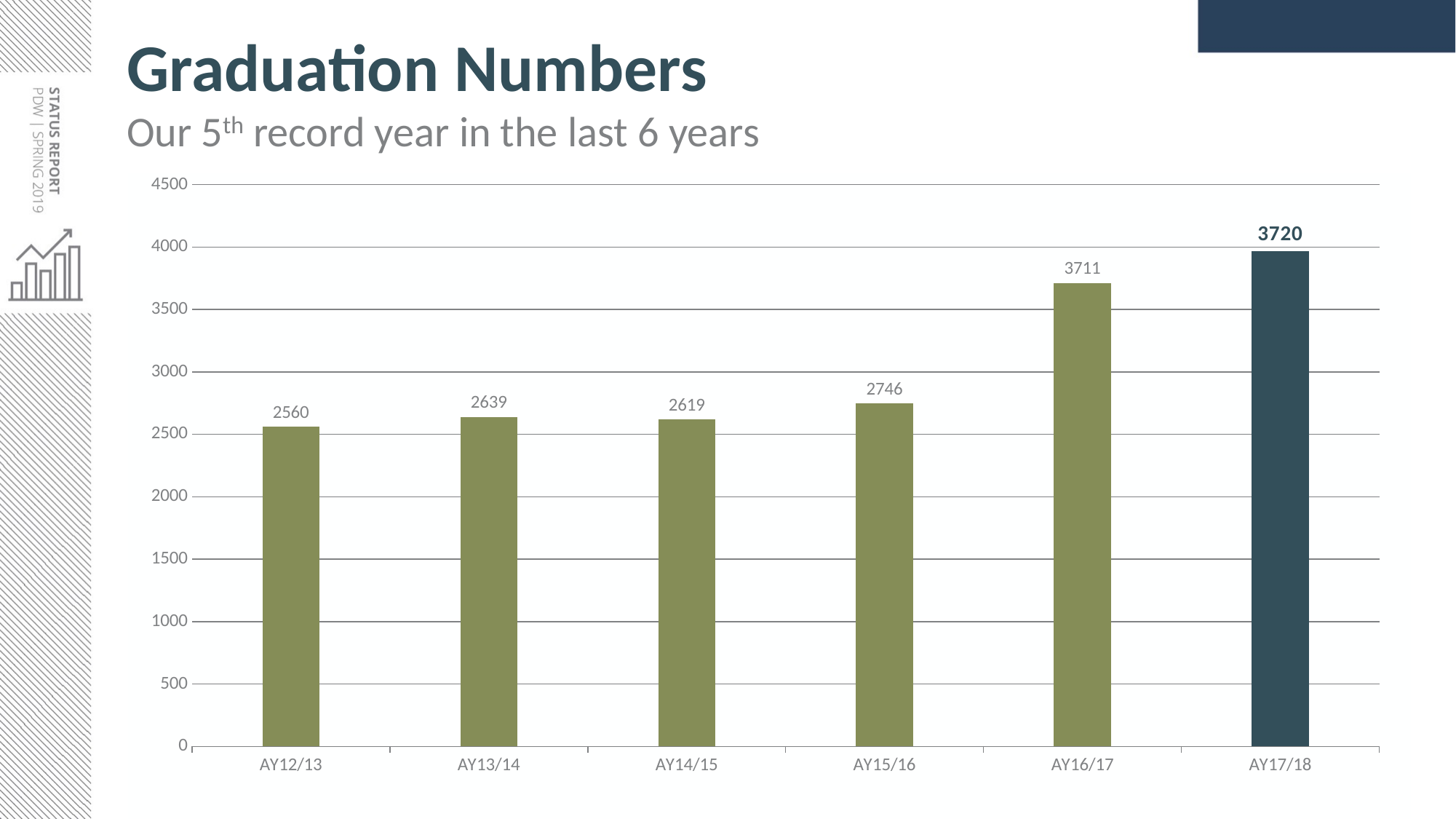
How many academic years are shown on the chart? 6 What is the graduation number for AY15/16? 2746 What kind of chart is shown on the slide? bar chart What is the difference between the graduation numbers for AY16/17 and AY15/16? 965 Which academic year has the lowest graduation number? AY12/13 Which bar is shown in a different colour from the others? AY17/18 What is the graduation number for AY17/18? 3720 What is the difference between the graduation numbers for AY13/14 and AY14/15? 20 Which academic year has the highest graduation number? AY17/18 What is the graduation number for AY12/13? 2560 Which is larger, the graduation number for AY13/14 or AY14/15? AY13/14 Is the value for AY16/17 greater or less than 3500? greater